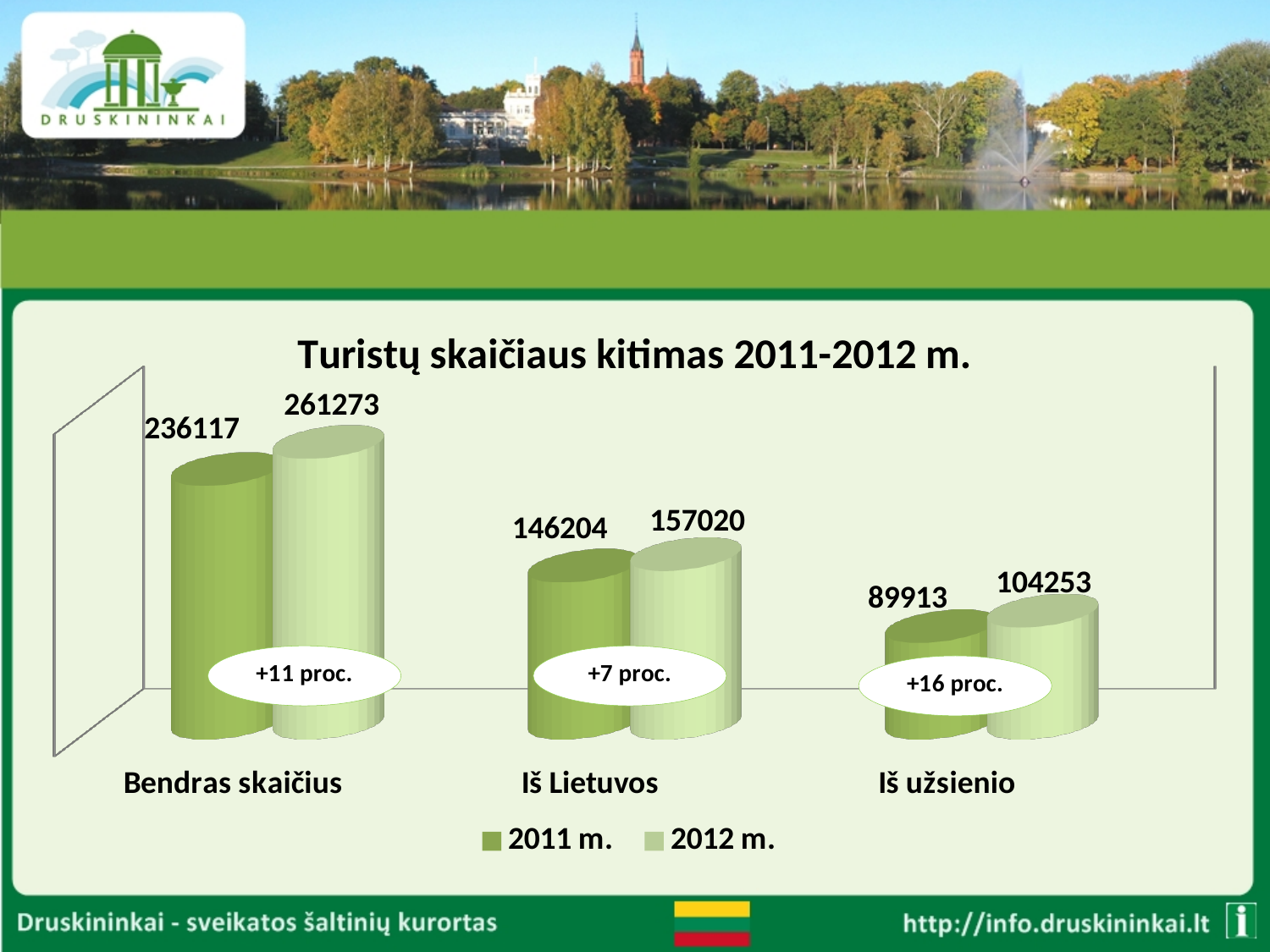
Which category has the highest value in the 2012 m. series? Bendras skaičius What is the value for 'Bendras skaičius' in the 2011 m. series? 236117 What is the difference between the 2012 m. and 2011 m. values for 'Iš užsienio'? 14340 What is the difference between the 2012 m. and 2011 m. values for 'Bendras skaičius'? 25156 Which is larger: the 2011 m. value for 'Iš Lietuvos' or the 2012 m. value for 'Iš užsienio'? 2011 m. value for 'Iš Lietuvos' How many series does the legend list? 2 What is the value for 'Iš užsienio' in the 2012 m. series? 104253 What percentage change is labelled for 'Iš užsienio'? +16 proc. How many categories are shown on the x axis? 3 What is the value for 'Iš Lietuvos' in the 2012 m. series? 157020 What kind of chart is shown on the slide? Bar chart Which category has the lowest value in the 2011 m. series? Iš užsienio